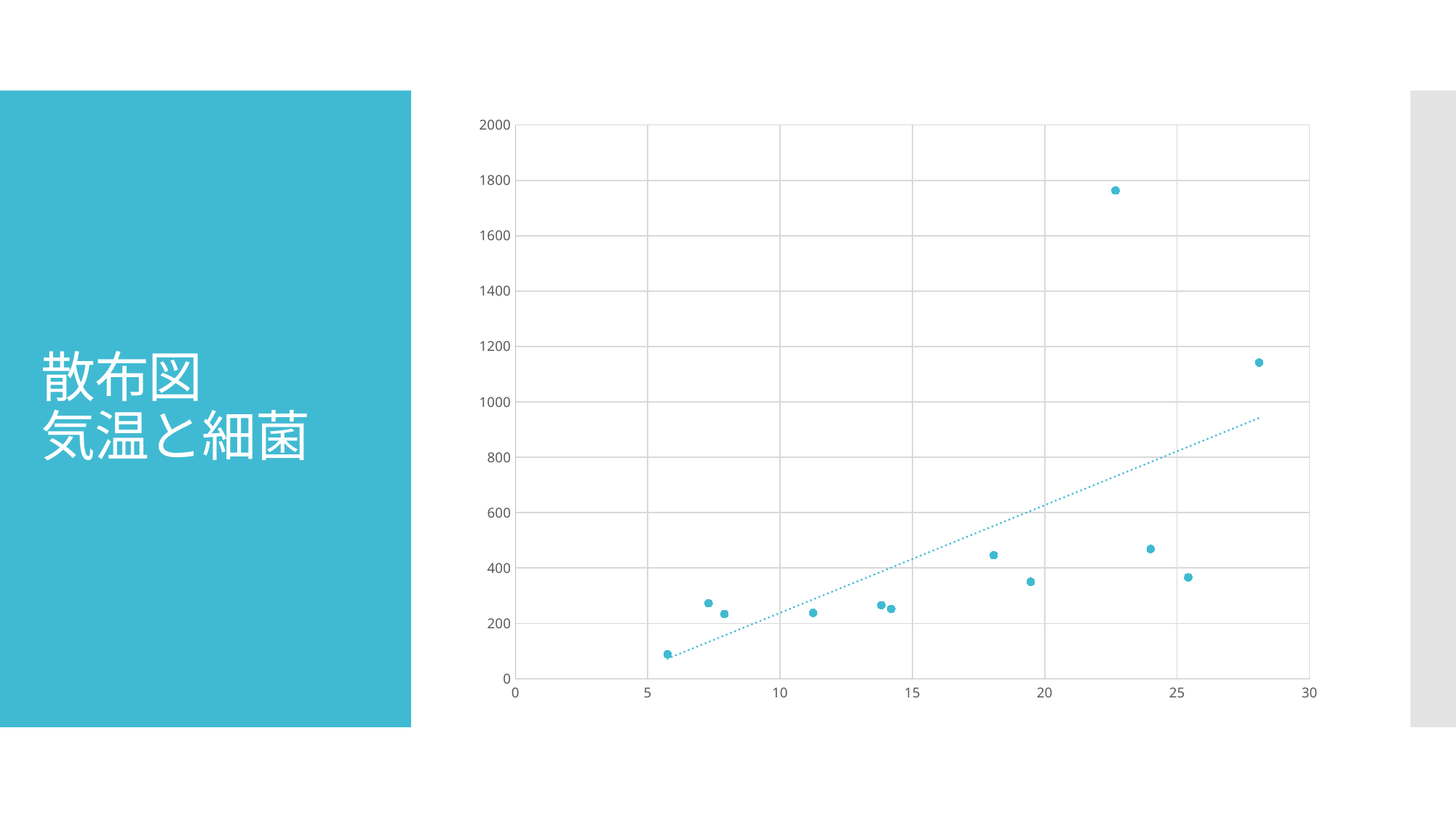
What is the maximum value shown on the vertical axis of the chart? 2000 What is the title text shown on the left of the slide? 散布図 気温と細菌 Which is larger: the value of the point near x = 22.5 or the value of the point near x = 28? the point near x = 22.5 Is the value of the point near x = 28 greater or less than 1000? greater Does the dotted trend line on the chart rise or fall as the x value increases? rise Is the value of the lowest point on the chart (near x = 6) greater or less than 200? less Is the value of the highest point on the chart (near x = 22.5) greater or less than 1600? greater How many data points are plotted on the scatter chart? 12 What kind of chart is shown on the slide? scatter chart